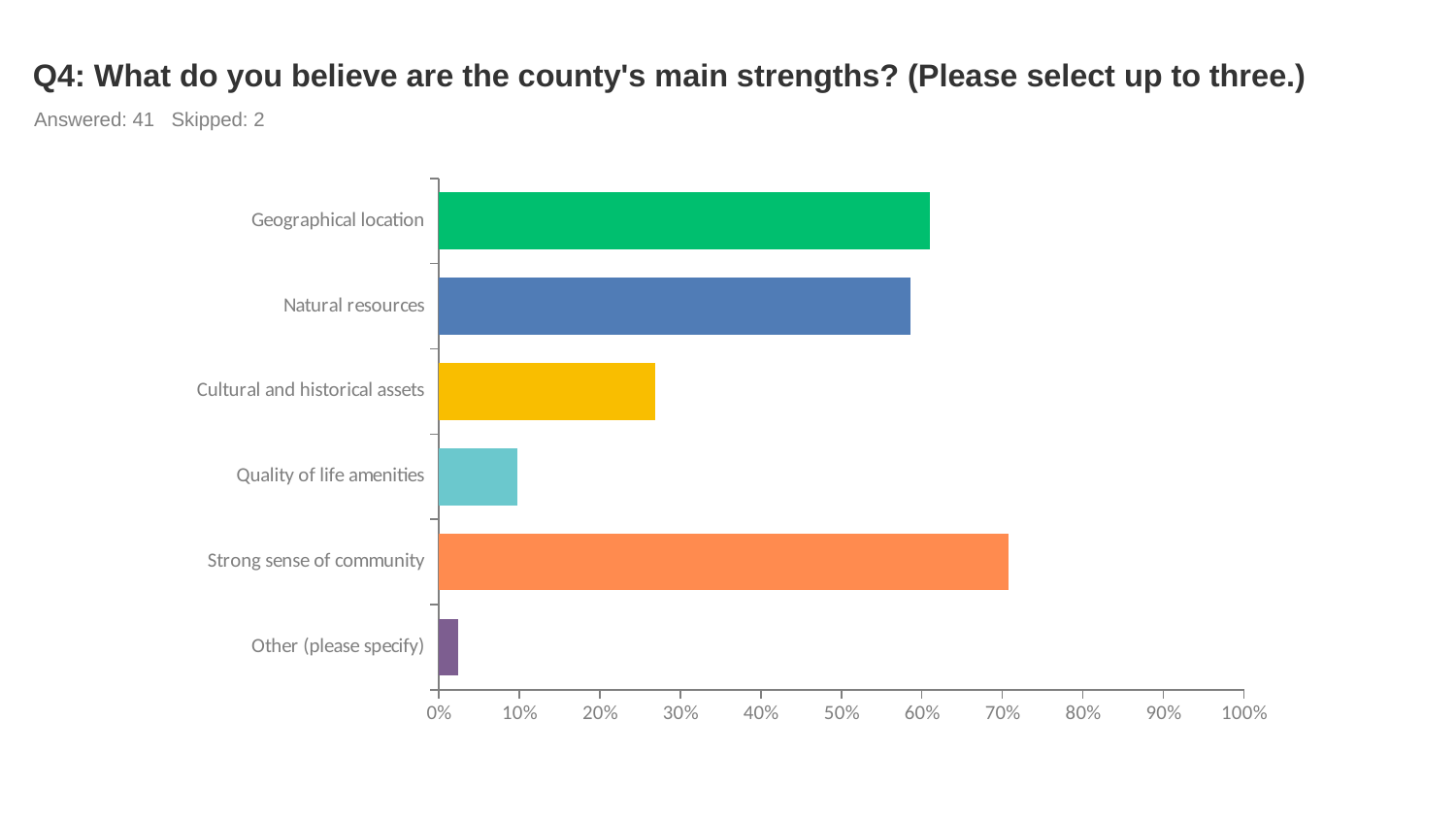
Which category has the lowest value? Other (please specify) How many categories are shown in the chart? 6 Is the value for Geographical location greater or less than 50%? greater Is the value for Strong sense of community greater or less than 60%? greater Which is larger, the value for Natural resources or the value for Cultural and historical assets? Natural resources Which is larger, the value for Cultural and historical assets or the value for Quality of life amenities? Cultural and historical assets Is the value for Quality of life amenities greater or less than 20%? less What kind of chart is shown on the slide? bar chart Which category has the highest value? Strong sense of community How many respondents answered this question according to the slide? 41